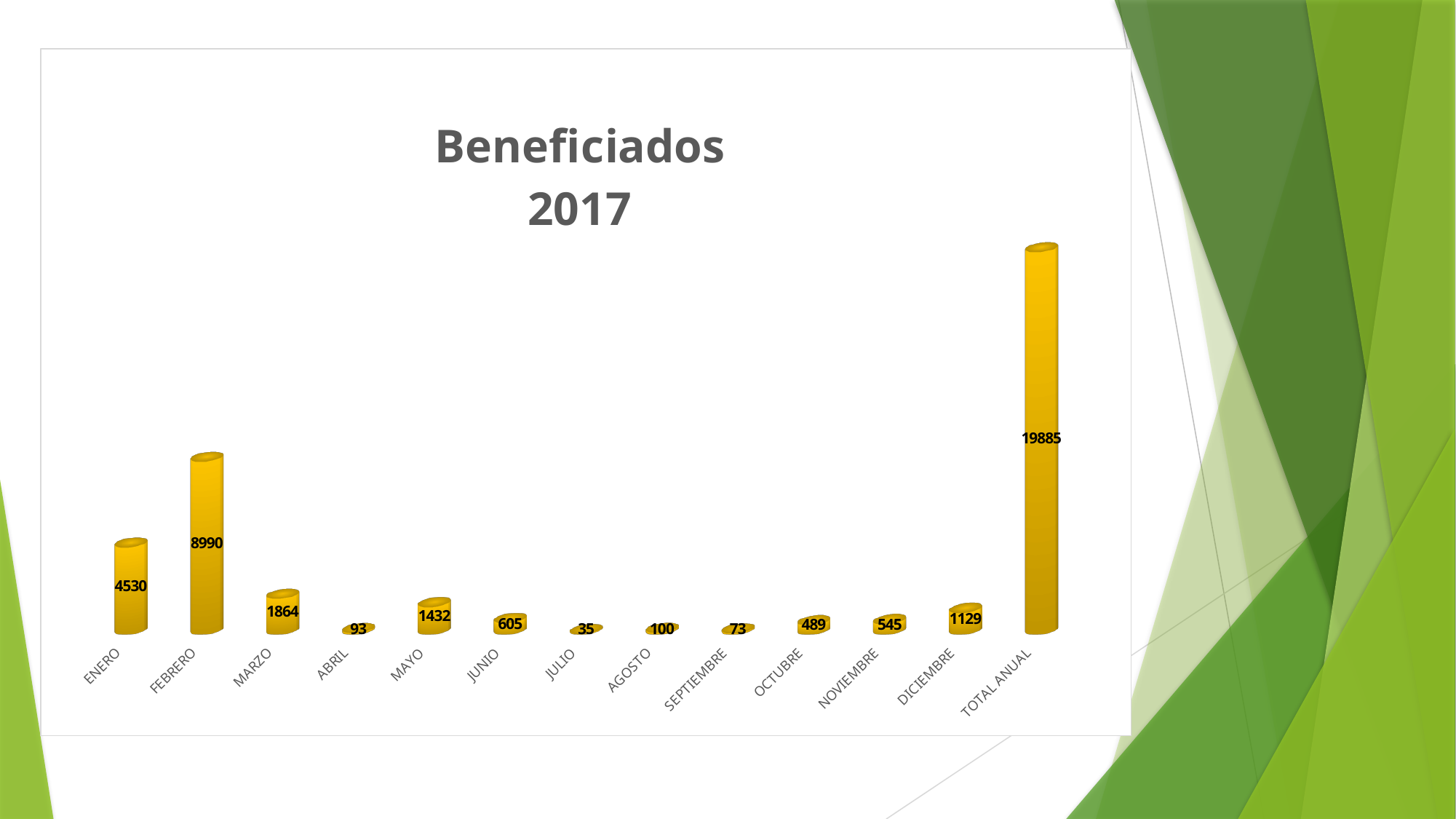
Which category has the lowest value? JULIO What is the value for ENERO? 4530 What is the difference between the values for FEBRERO and ENERO? 4460 What is the difference between the values for MARZO and MAYO? 432 How many categories are shown on the x axis? 13 What is the title of the chart? Beneficiados 2017 Which is larger, the value for OCTUBRE or the value for NOVIEMBRE? NOVIEMBRE What is the value for DICIEMBRE? 1129 Which month (excluding TOTAL ANUAL) has the highest value? FEBRERO What is the value for FEBRERO? 8990 What kind of chart is shown on the slide? Bar chart What is the value shown for TOTAL ANUAL? 19885